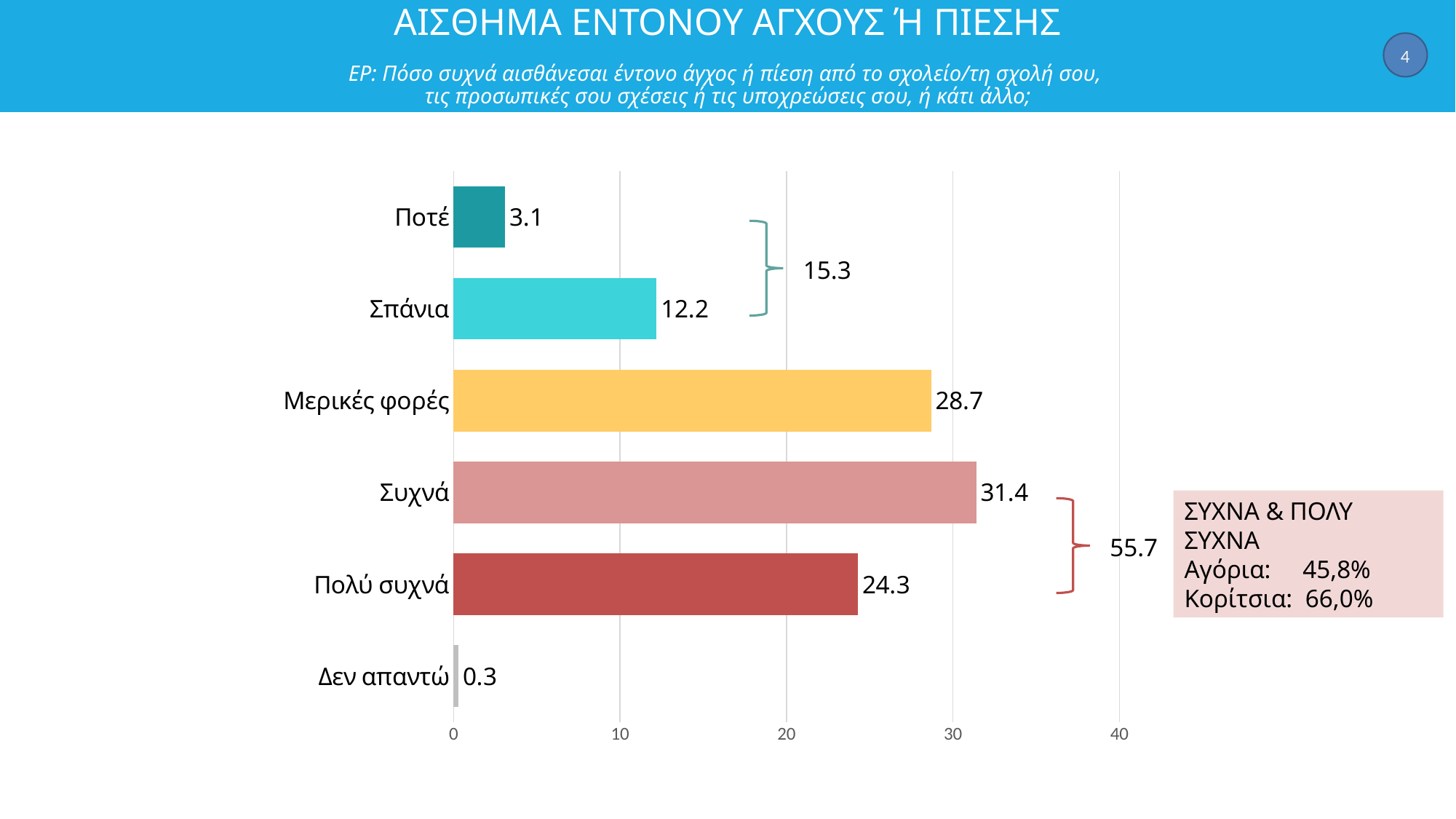
What combined value is shown by the bracket grouping Συχνά and Πολύ συχνά? 55.7 What combined value is shown by the bracket grouping Ποτέ and Σπάνια? 15.3 Is the value for Μερικές φορές greater or less than 20? greater What is the value for Συχνά? 31.4 What is the difference between the values for Μερικές φορές and Πολύ συχνά? 4.4 Which category has the highest value? Συχνά Which is larger, the value for Ποτέ or the value for Σπάνια? Σπάνια What kind of chart is shown on the slide? bar chart What is the value for Δεν απαντώ? 0.3 Which category has the lowest value? Δεν απαντώ What is the value for Σπάνια? 12.2 How many categories are shown in the chart? 6